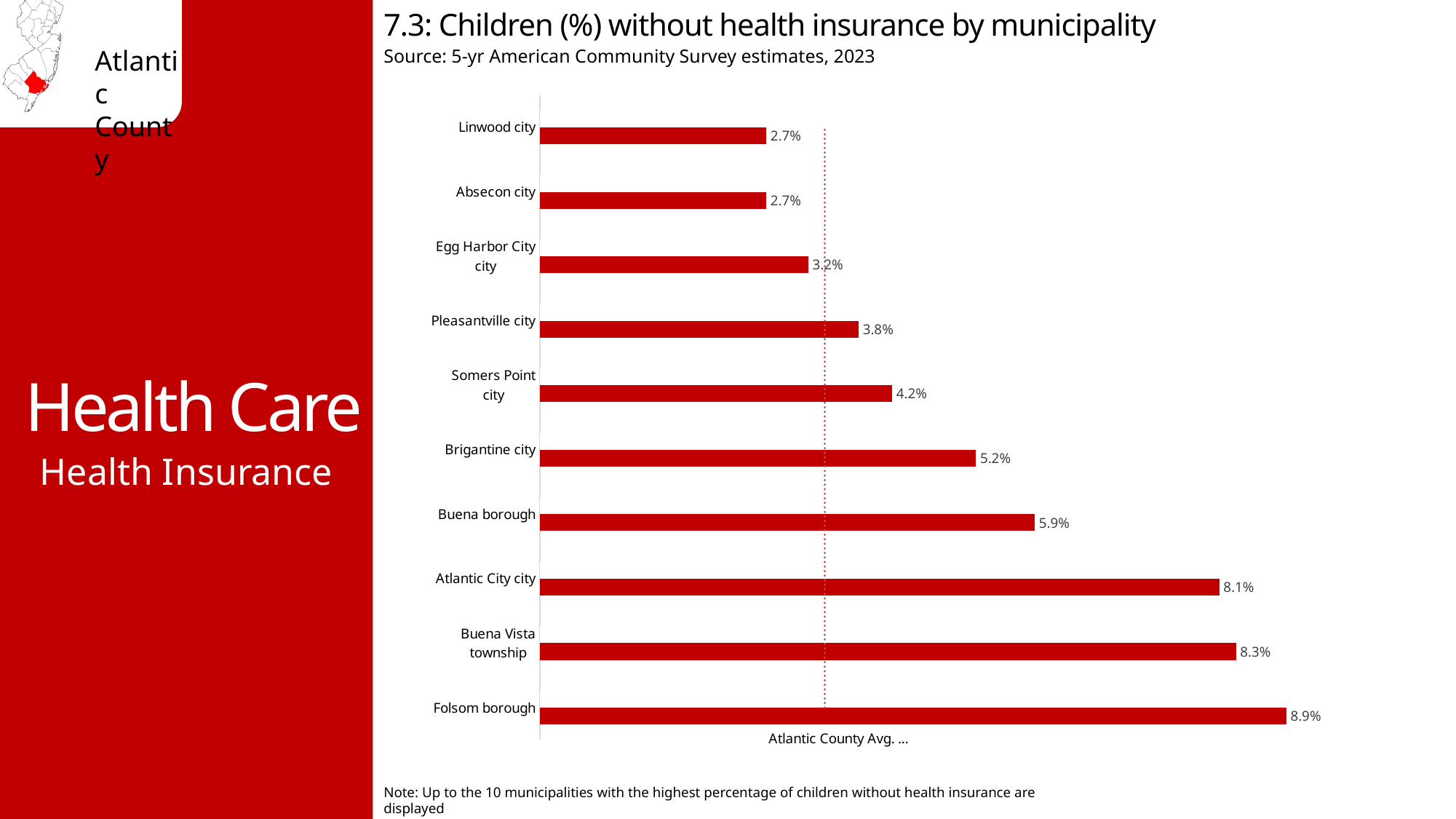
How many municipalities are shown in the chart? 10 What is the value shown for Pleasantville city? 3.8% What is the difference between the values for Folsom borough and Linwood city? 6.2% Which municipality has the highest percentage of children without health insurance? Folsom borough What does the dotted vertical line in the chart represent? Atlantic County Avg. What is the source of the data shown in the chart? 5-yr American Community Survey estimates, 2023 What is the value shown for Buena Vista township? 8.3% Which two municipalities share the same value of 2.7%? Linwood city and Absecon city Which has a higher value, Buena borough or Somers Point city? Buena borough What kind of chart is shown on the slide? Bar chart What percentage of children are without health insurance in Folsom borough? 8.9% What is the difference between the values for Atlantic City city and Brigantine city? 2.9%